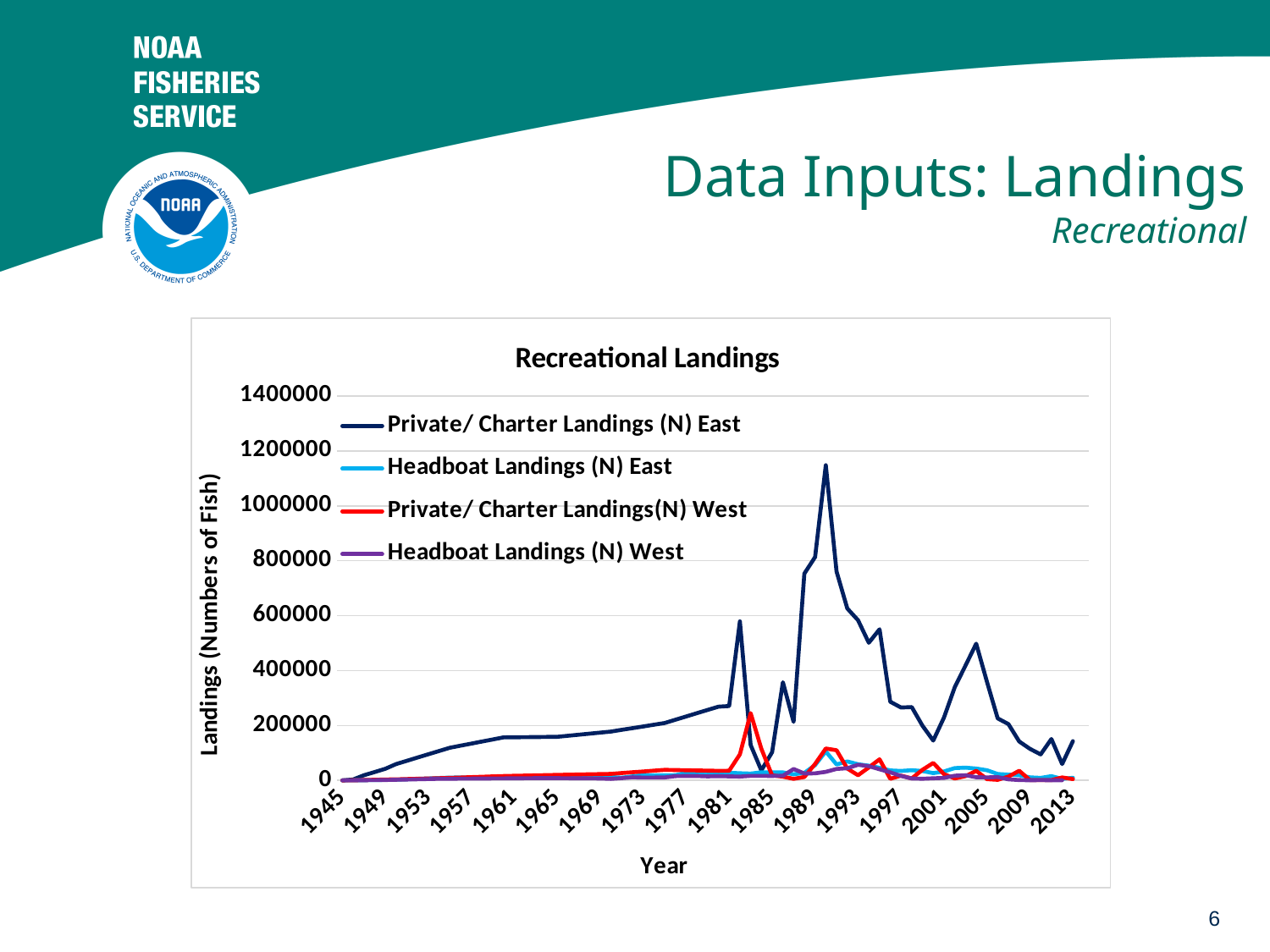
What is the label of the y axis? Landings (Numbers of Fish) Which series reaches the highest value on the chart? Private/ Charter Landings (N) East What is the highest value shown on the y axis? 1400000 What is the title of the chart? Recreational Landings How many series does the legend of the Recreational Landings chart list? 4 Does Private/ Charter Landings (N) East rise or fall between 1991 and 2001? fall Does Private/ Charter Landings (N) East rise or fall between 1945 and 1981? rise Is the value of Private/ Charter Landings (N) East in 1981 greater or less than 200000? greater Is the peak value of Private/ Charter Landings(N) West greater or less than 400000? less What kind of chart is shown on the slide? line chart Which series is larger around 1991: Private/ Charter Landings (N) East or Headboat Landings (N) East? Private/ Charter Landings (N) East Is the peak value of Private/ Charter Landings (N) East greater or less than 1000000? greater